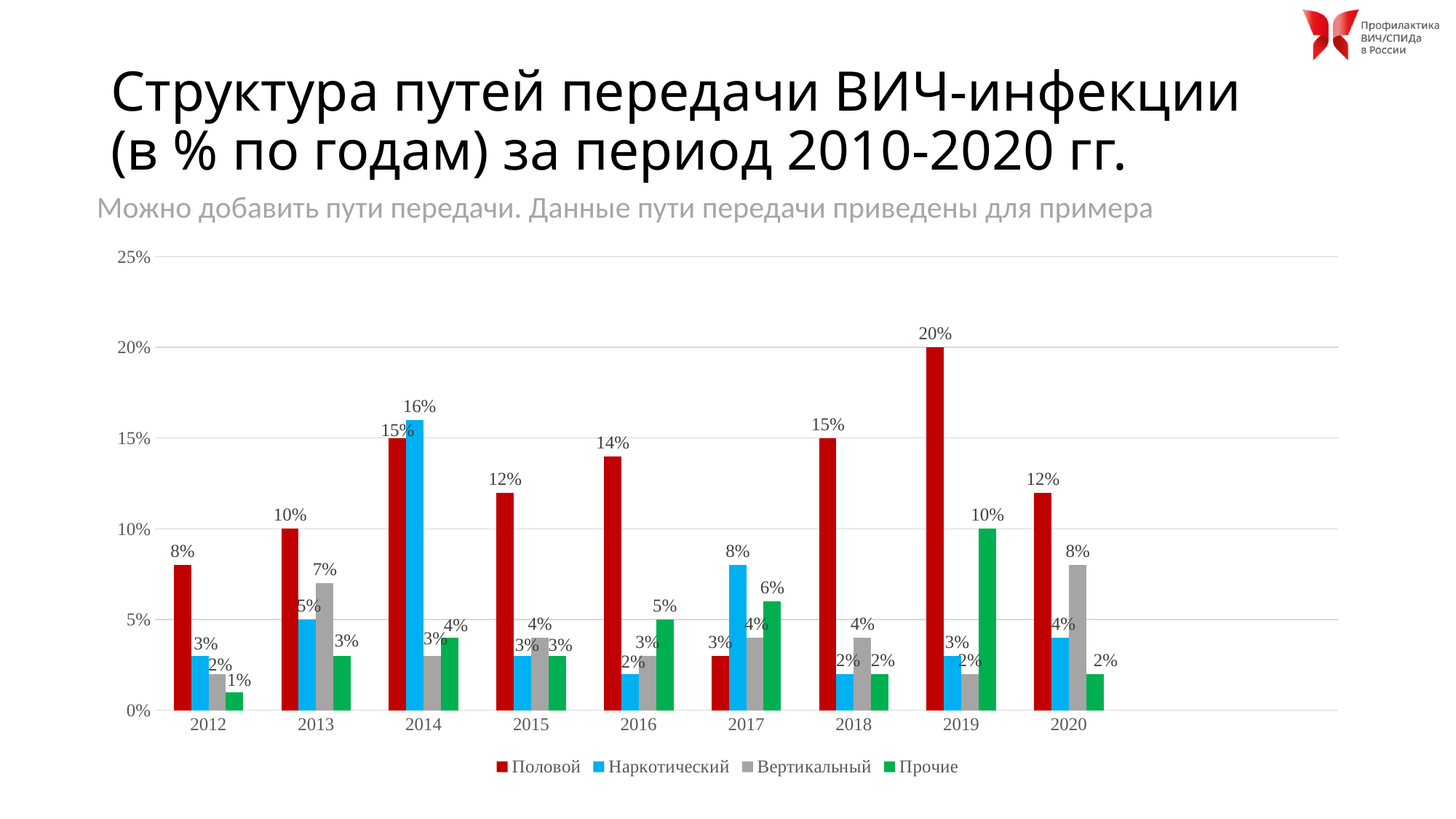
In which year is the Половой value highest? 2019 What is the value for Вертикальный in 2020? 8% What is the value for Прочие in 2017? 6% What is the value for Половой in 2019? 20% In which year is the Половой value lowest? 2017 How many series does the legend list? 4 What is the value for Наркотический in 2014? 16% How many years are shown on the x axis? 9 Is the value for Прочие in 2019 greater or less than 5%? greater Which is larger in 2014: Половой or Наркотический? Наркотический What kind of chart is shown on the slide? Bar chart What is the difference between the Половой values in 2019 and 2020? 8%